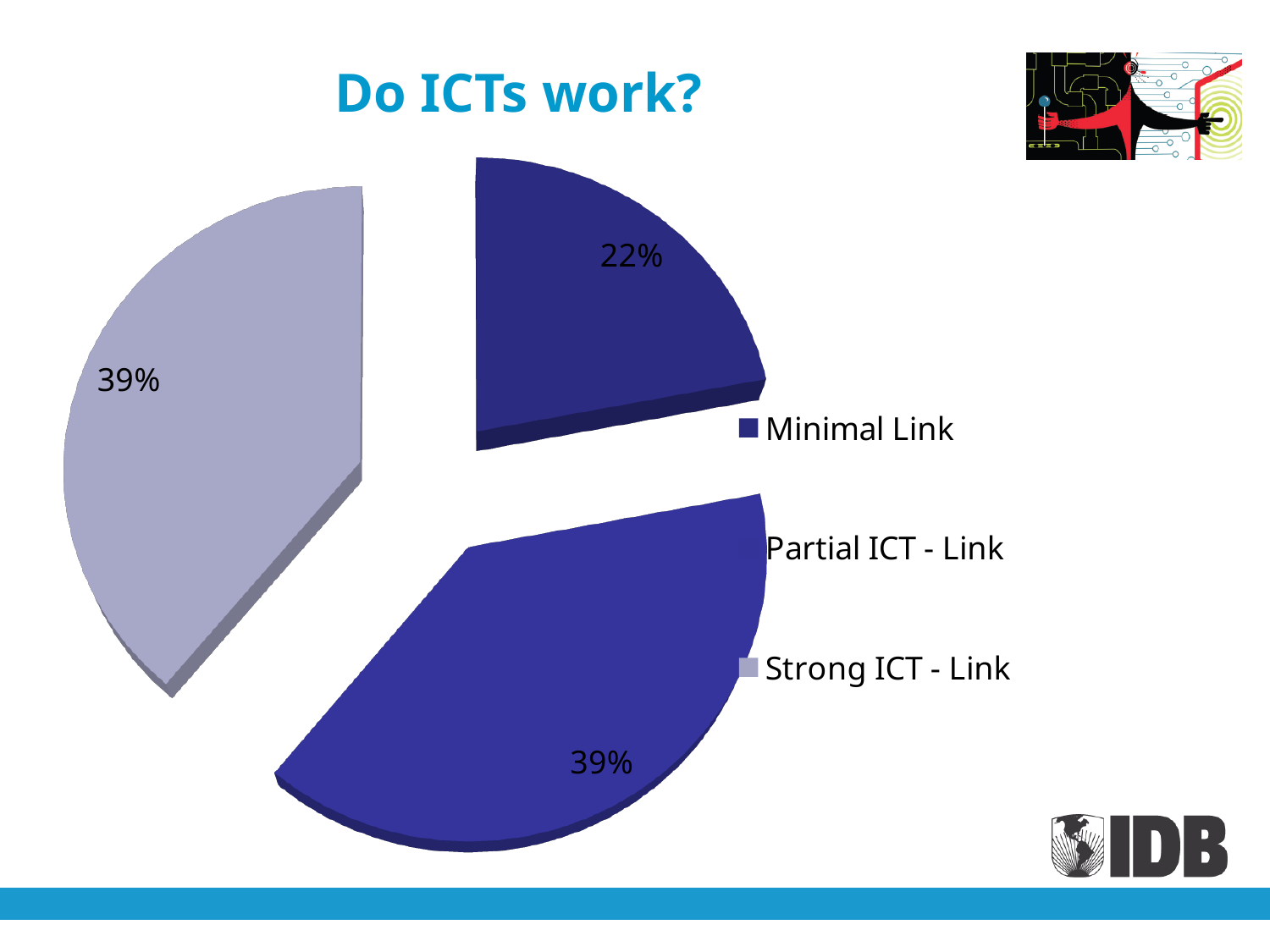
Which category has the smallest slice of the pie? Minimal Link Which is larger, the Strong ICT - Link slice or the Minimal Link slice? Strong ICT - Link Which category is shown in the lightest colour in the legend? Strong ICT - Link How many slices does the pie chart have? 3 What share of the pie does the Partial ICT - Link slice represent? 39% By how many percentage points does the Strong ICT - Link slice exceed the Minimal Link slice? 17 percentage points Which is larger, the Minimal Link slice or the Partial ICT - Link slice? Partial ICT - Link What share of the pie does the Minimal Link slice represent? 22% What kind of chart is shown on the slide? Pie chart What share of the pie does the Strong ICT - Link slice represent? 39% What is the title of the slide containing the chart? Do ICTs work?